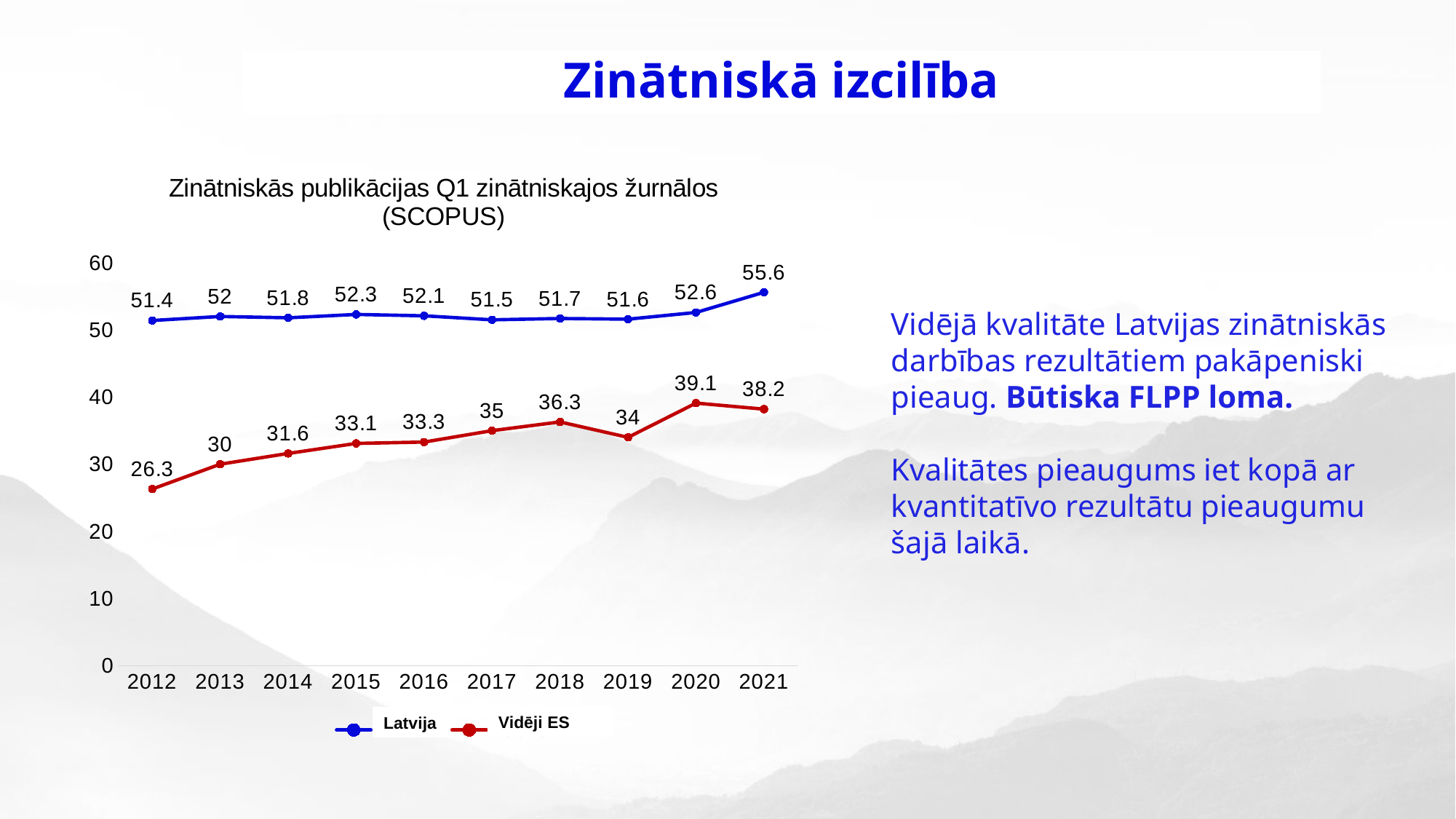
What is the difference between the Latvija and Vidēji ES values in 2021? 17.4 How many series does the legend list? 2 What is the value for Vidēji ES in 2020? 39.1 What is the value for Latvija in 2021? 55.6 In which year is the Latvija series at its lowest? 2012 Does the Vidēji ES series generally rise or fall from 2012 to 2021? Rise Which series has the higher value in 2018, Latvija or Vidēji ES? Latvija What kind of chart is shown on the slide? Line chart How many years are shown on the x axis? 10 What is the value for Vidēji ES in 2012? 26.3 In which year is the Vidēji ES series at its highest? 2020 Is the value for Vidēji ES in 2019 greater or less than 30? greater